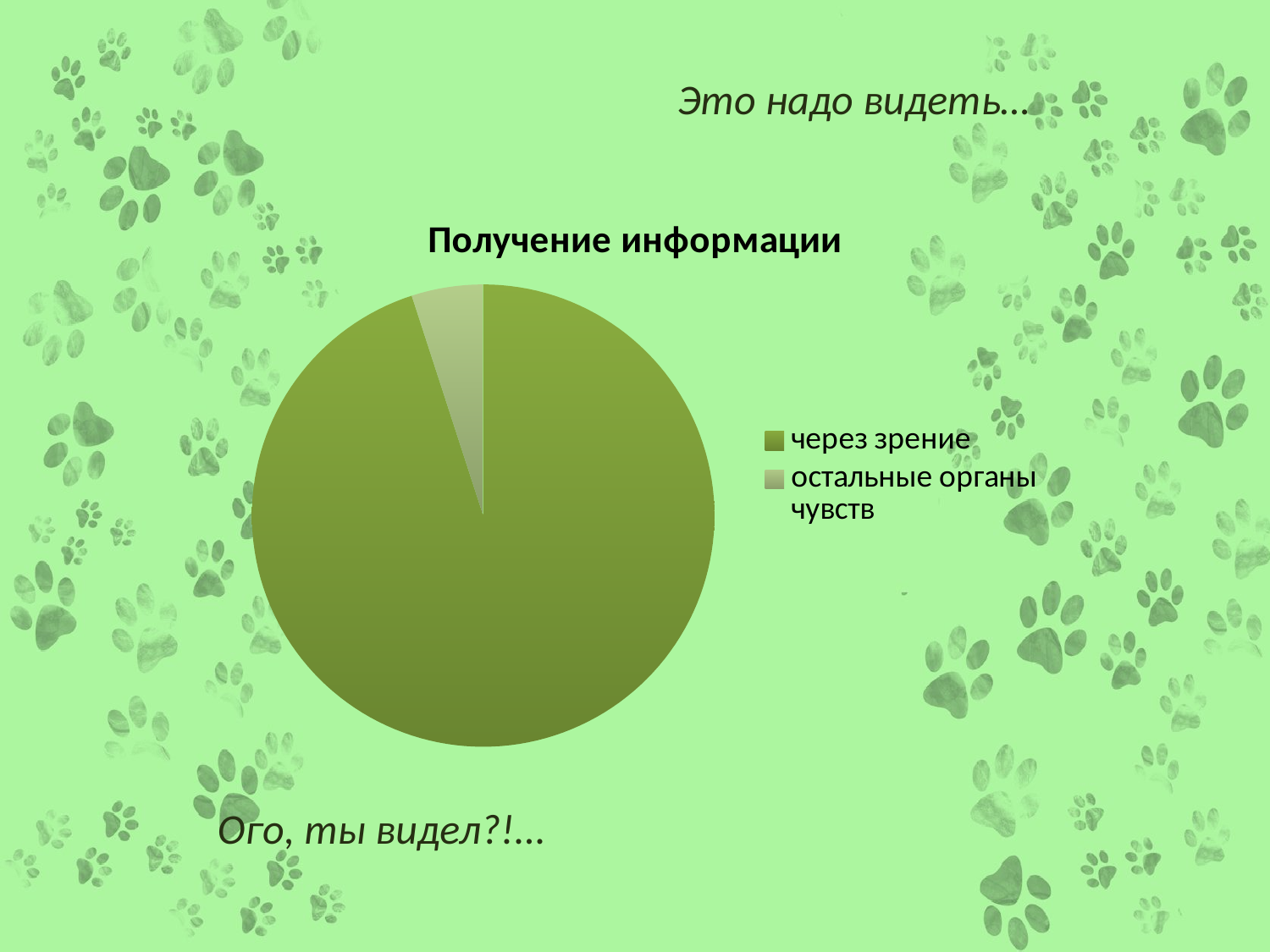
What is the title of the chart? Получение информации Which legend entry is shown in the lighter colour? остальные органы чувств Which slice is larger: "через зрение" or "остальные органы чувств"? через зрение Which category has the smallest slice of the pie? остальные органы чувств What kind of chart is shown on the slide? pie chart Which category has the largest slice of the pie? через зрение How many entries does the legend list? 2 How many slices does the pie chart have? 2